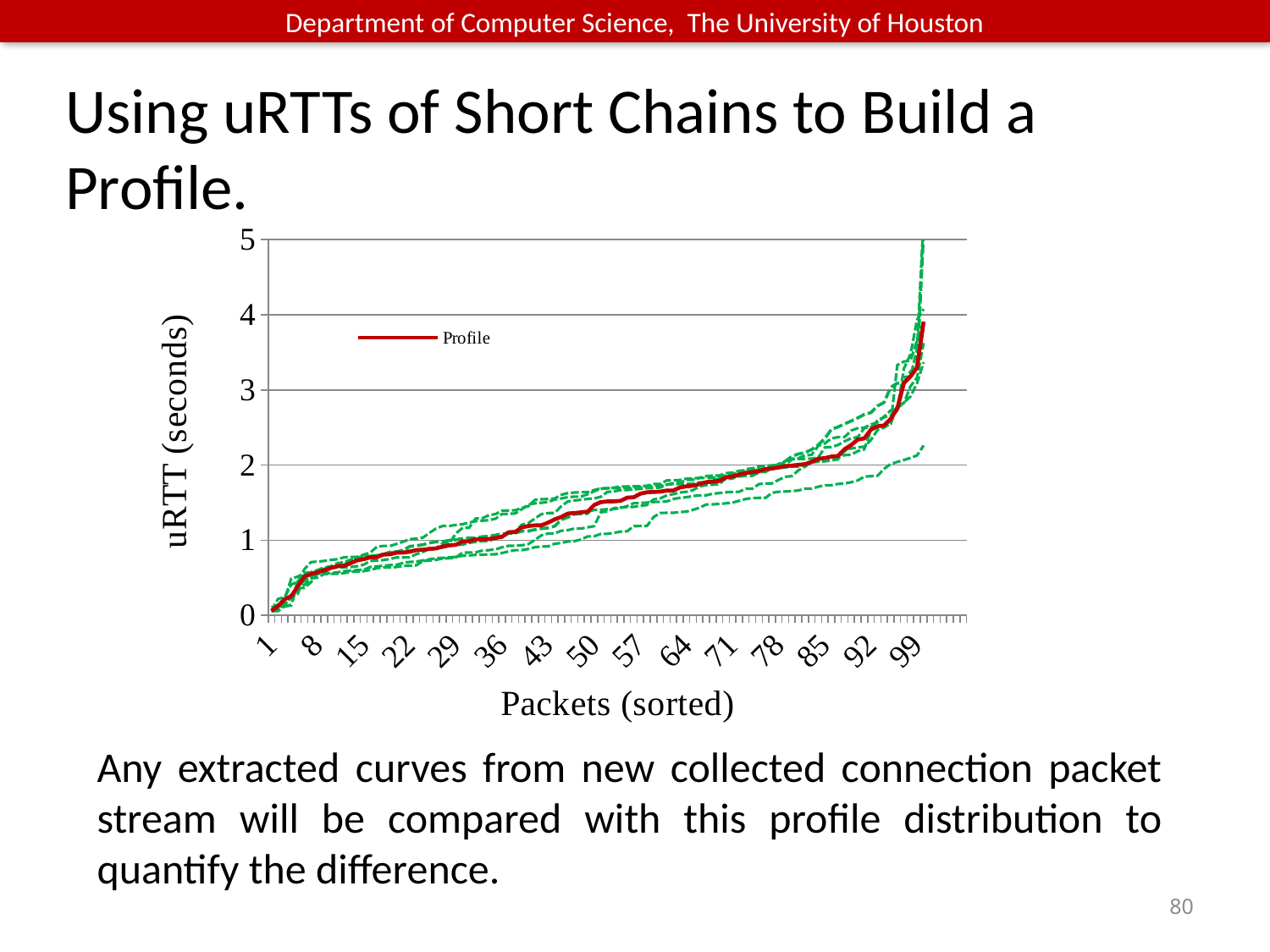
How many series does the chart's legend list? 1 Is the Profile value at packet 99 greater or less than 3? greater Is the Profile value at packet 1 greater or less than 1? less Is the Profile value at packet 71 greater or less than 2? less What is the highest value shown on the y axis of the chart? 5 What is the title of the x axis of the chart? Packets (sorted) Does the Profile line rise or fall as the packet index increases along the x axis? rise What is the title of the y axis of the chart? uRTT (seconds) What kind of chart is shown on the slide? line chart